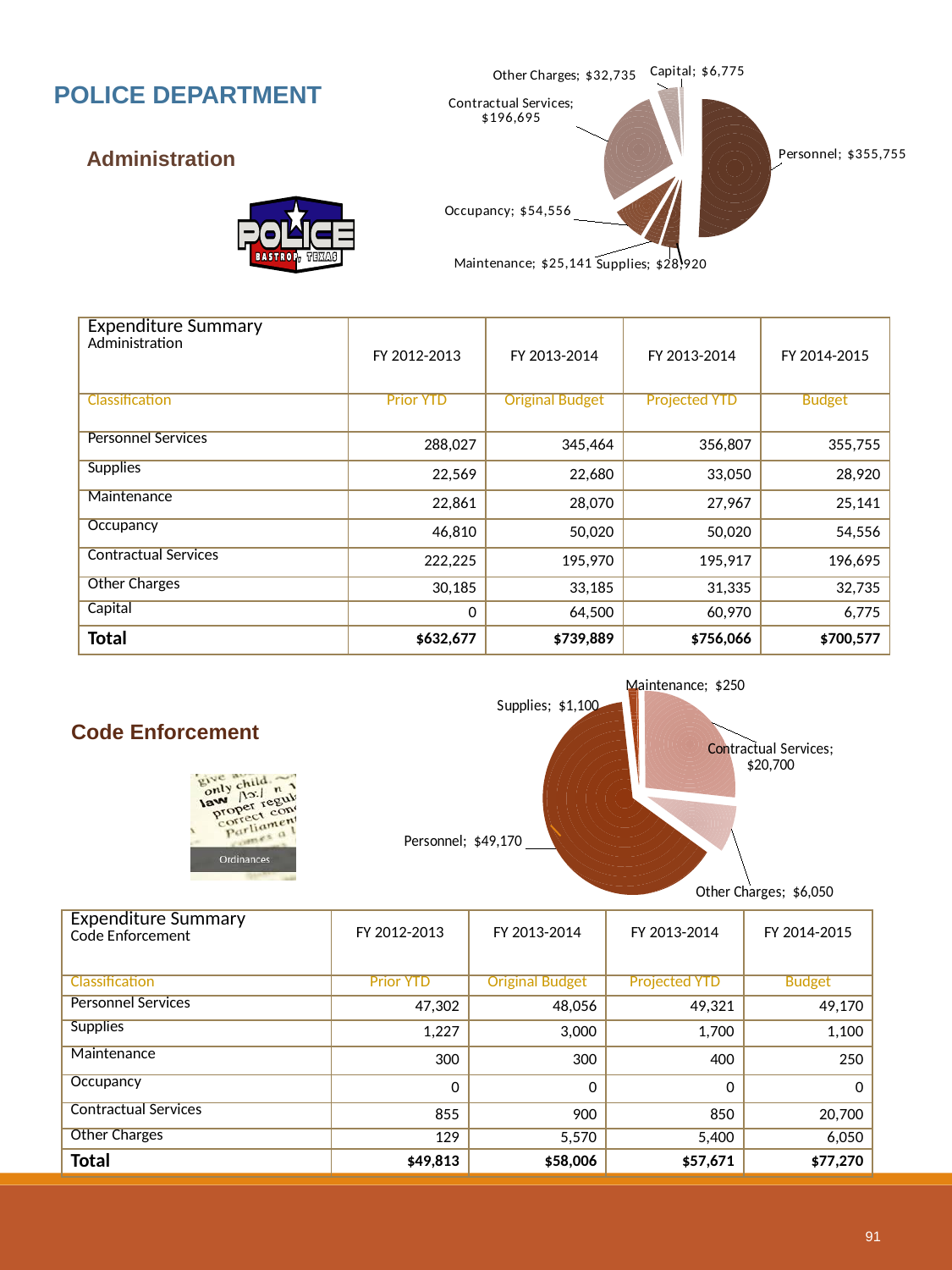
What type of chart is the bottom chart? Pie chart In the bottom pie chart, which category has the smallest value? Maintenance How many slices does the bottom pie chart have? 5 In the top pie chart, what is the difference between Contractual Services and Occupancy? $142,139 In the top pie chart, which category has the smallest value? Capital In the bottom pie chart, what is the difference between Contractual Services and Other Charges? $14,650 In the top pie chart, which category has the largest value? Personnel In the top pie chart, which is larger, Supplies or Maintenance? Supplies In the top pie chart, what is the value for Contractual Services? $196,695 How many slices does the top pie chart have? 7 In the top pie chart, what is the value for Personnel? $355,755 In the bottom pie chart, what is the value for Contractual Services? $20,700